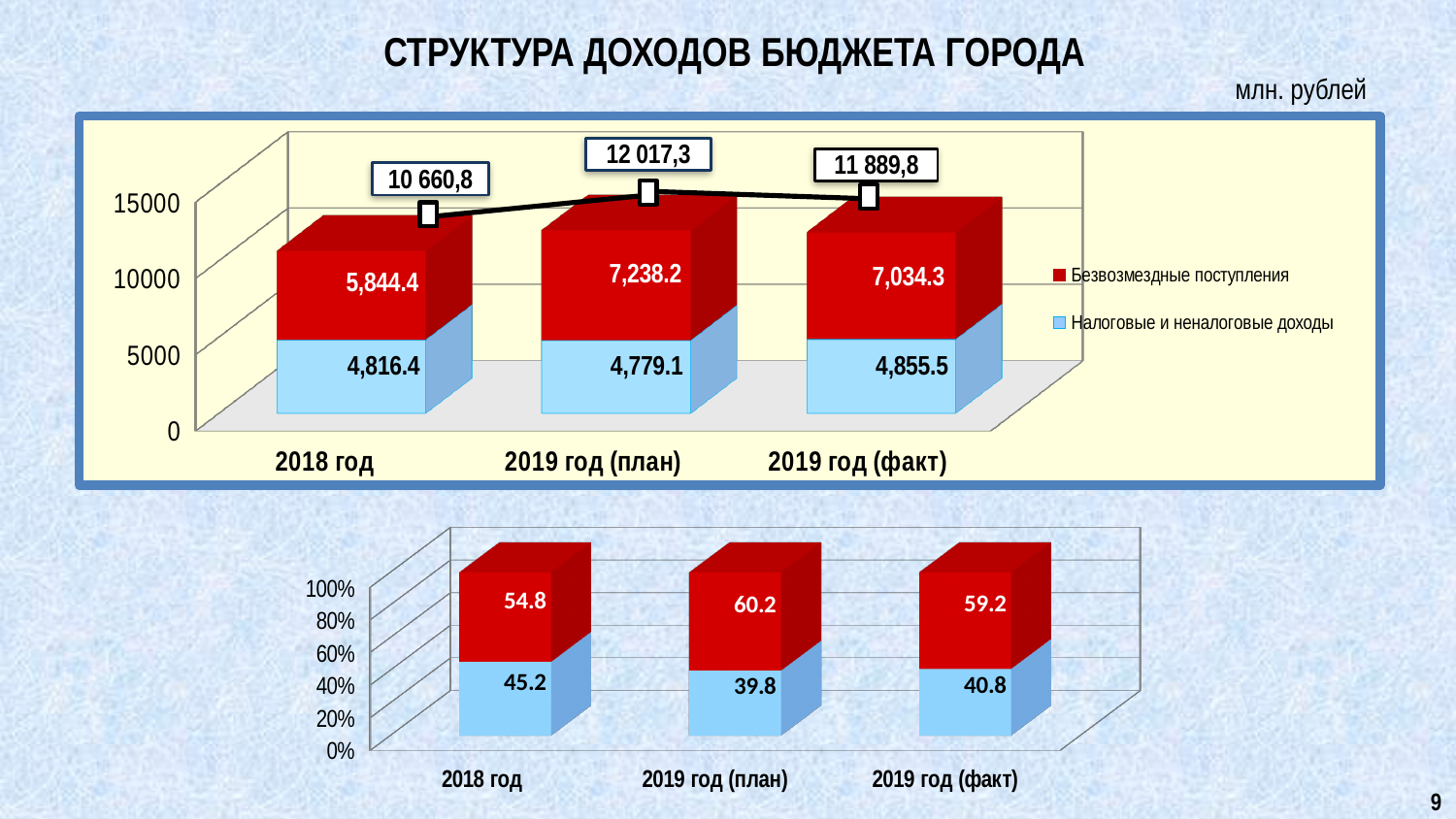
In the top chart, which category has the highest total? 2019 год (план) In the top chart, what is the difference between Безвозмездные поступления for 2019 год (план) and 2019 год (факт)? 203.9 In the top chart, what is the value of Налоговые и неналоговые доходы for 2019 год (факт)? 4,855.5 In the top chart, what is the value of Безвозмездные поступления for 2019 год (план)? 7,238.2 How many categories are shown on the x axis of the top chart? 3 How many series does the legend of the top chart list? 2 What kind of chart is the top chart? Stacked bar chart In the top chart, what colour represents Безвозмездные поступления in the legend? Red In the top chart, what total is shown above the bar for 2018 год? 10 660,8 In the top chart, which is larger: Налоговые и неналоговые доходы for 2018 год or for 2019 год (план)? 2018 год In the bottom chart, what is the value of the red segment for 2019 год (факт)? 59.2 In the bottom chart, which category has the lowest value for the blue segment? 2019 год (план)